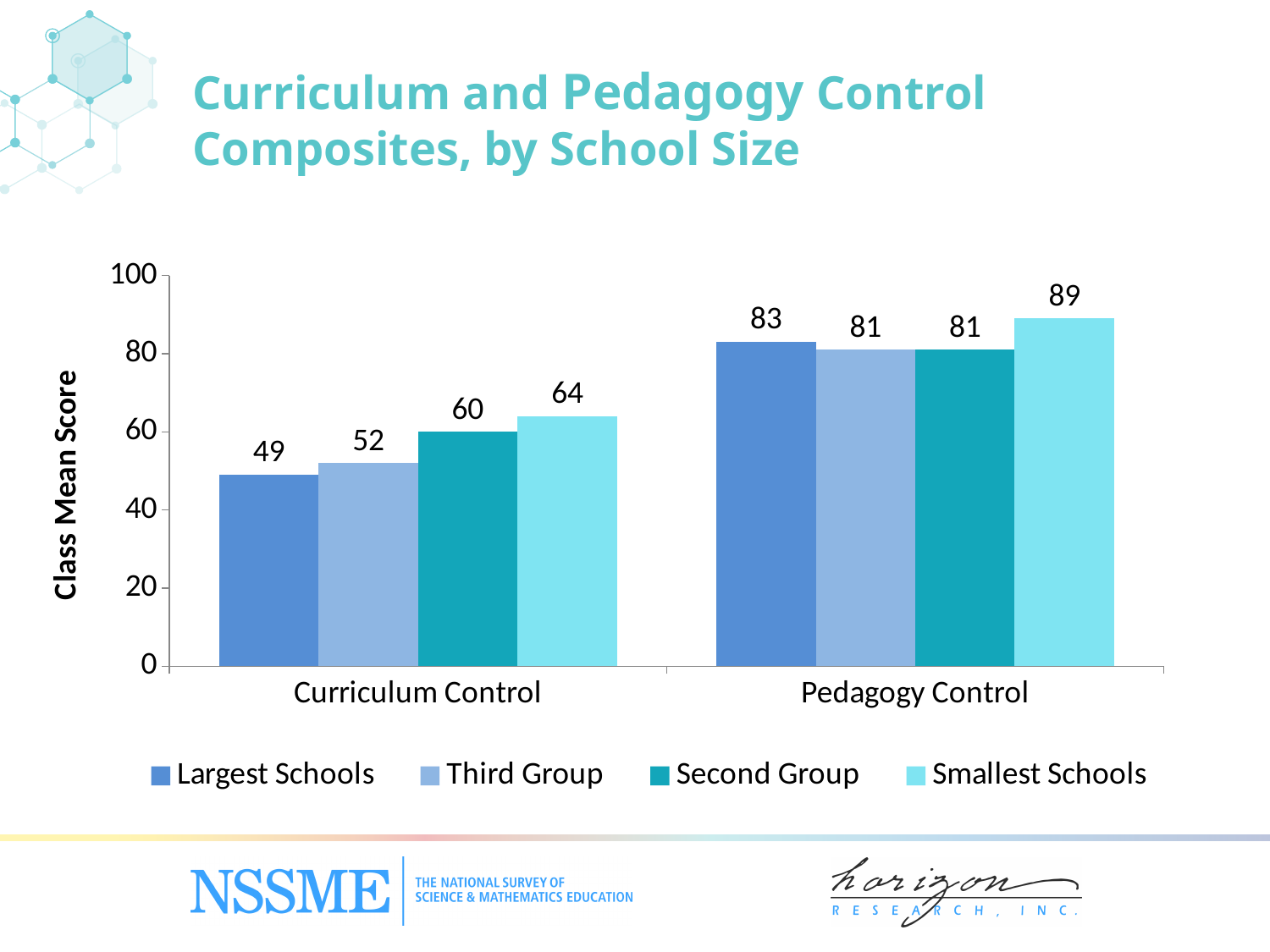
What is the difference between the Pedagogy Control and Curriculum Control scores for Third Group? 29 Which school size group has the lowest class mean score on Curriculum Control? Largest Schools What is the class mean score for Second Group on Curriculum Control? 60 Is the Third Group score on Curriculum Control greater or less than 60? less What kind of chart is shown on the slide? Bar chart How many series does the legend list? 4 Which school size group has the highest class mean score on Pedagogy Control? Smallest Schools What is the class mean score for Largest Schools on Curriculum Control? 49 Which is larger: the Largest Schools score on Pedagogy Control or the Smallest Schools score on Pedagogy Control? Smallest Schools What is the label on the vertical axis of the chart? Class Mean Score What is the difference between the Smallest Schools and Largest Schools scores on Curriculum Control? 15 What is the class mean score for Smallest Schools on Pedagogy Control? 89